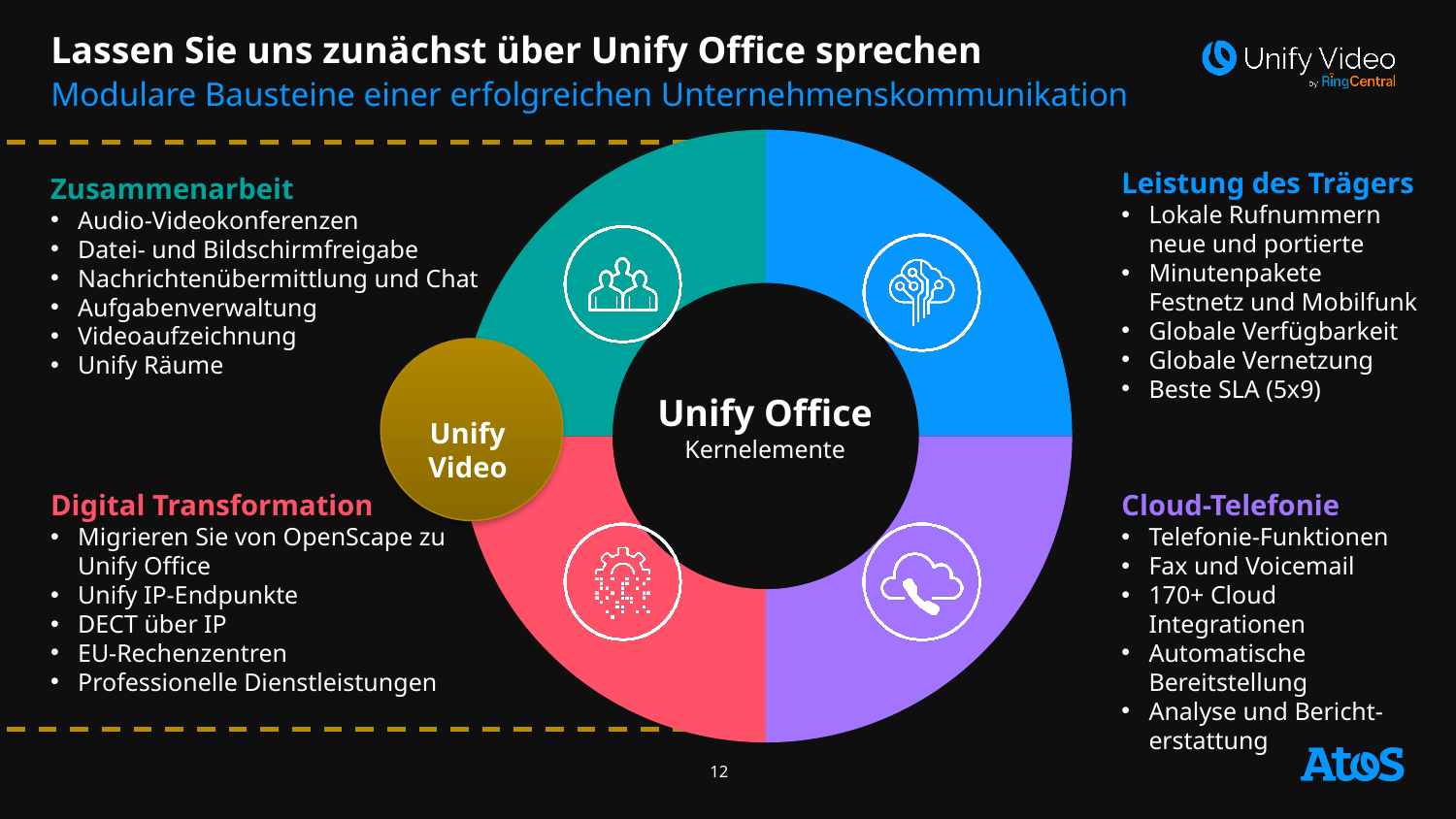
What colour is the top-right segment of the ring chart? blue What title is printed in the centre of the ring chart? Unify Office What kind of chart is the circular diagram in the centre of the slide? doughnut (pie) chart How many segments does the ring chart in the centre of the slide have? 4 Are the four segments of the ring chart equal in size? yes